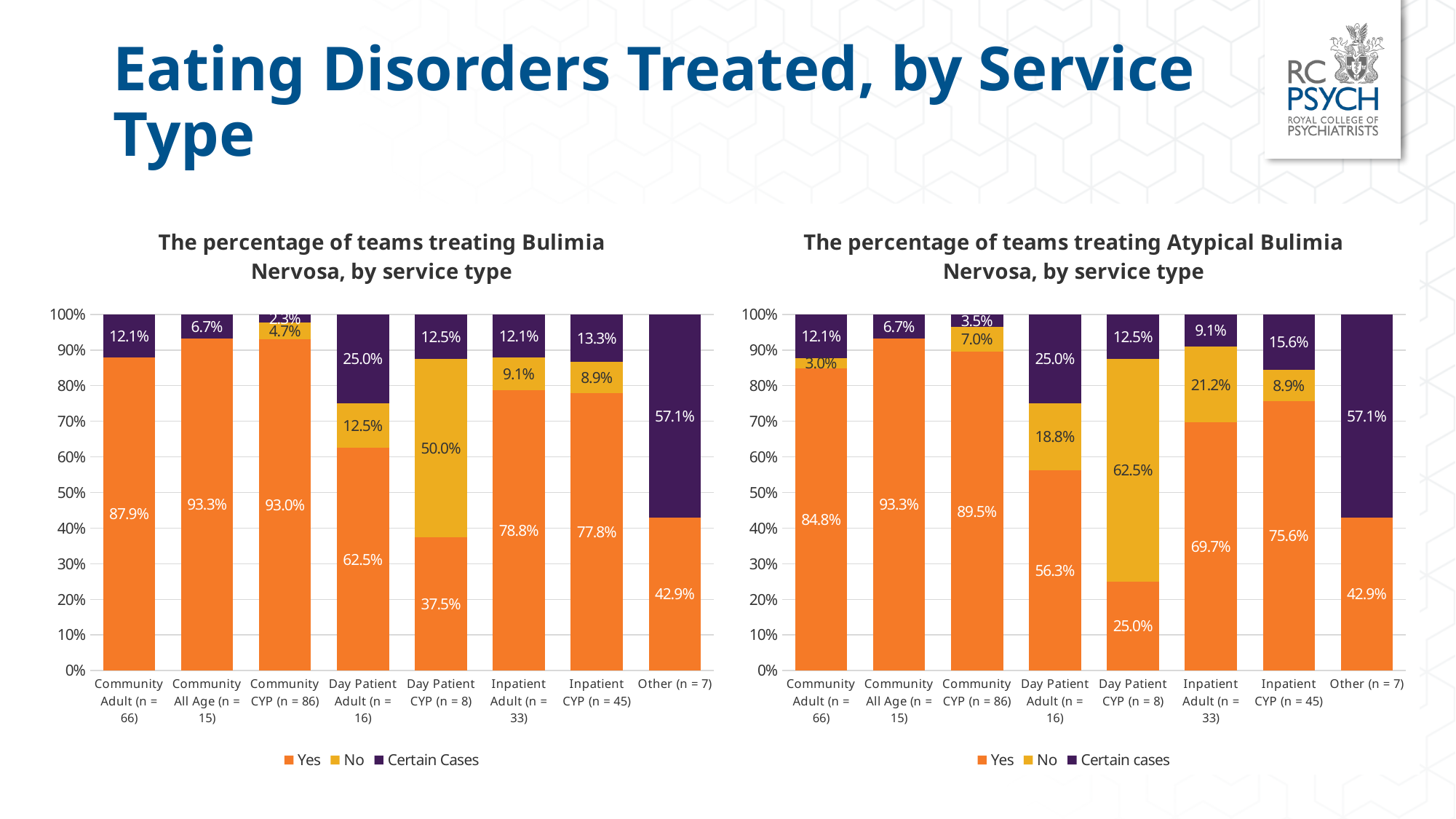
In the chart on the left (Bulimia Nervosa), what percentage of Community Adult teams answered Yes? 87.9% What type of chart is used for the Bulimia Nervosa chart on the left? Stacked bar chart In the chart on the right (Atypical Bulimia Nervosa), what is the No value for Day Patient CYP? 62.5% Which colour represents the Yes series in the chart on the left (Bulimia Nervosa)? Orange In the chart on the left (Bulimia Nervosa), what is the Certain Cases value for Community CYP (n = 86)? 2.3% In the chart on the right (Atypical Bulimia Nervosa), which service type has the highest Yes percentage? Community All Age (n = 15) In the chart on the right (Atypical Bulimia Nervosa), which is larger: the Certain cases value for Inpatient CYP or for Inpatient Adult? Inpatient CYP In the chart on the left (Bulimia Nervosa), what is the difference between the Yes values for Inpatient Adult and Day Patient Adult? 16.3% How many series does the legend list in the chart on the right (Atypical Bulimia Nervosa)? 3 How many service type categories are shown in the chart on the left (Bulimia Nervosa)? 8 In the chart on the right (Atypical Bulimia Nervosa), what is the Certain cases value for Other (n = 7)? 57.1% In the chart on the left (Bulimia Nervosa), which service type has the lowest Yes percentage? Day Patient CYP (n = 8)